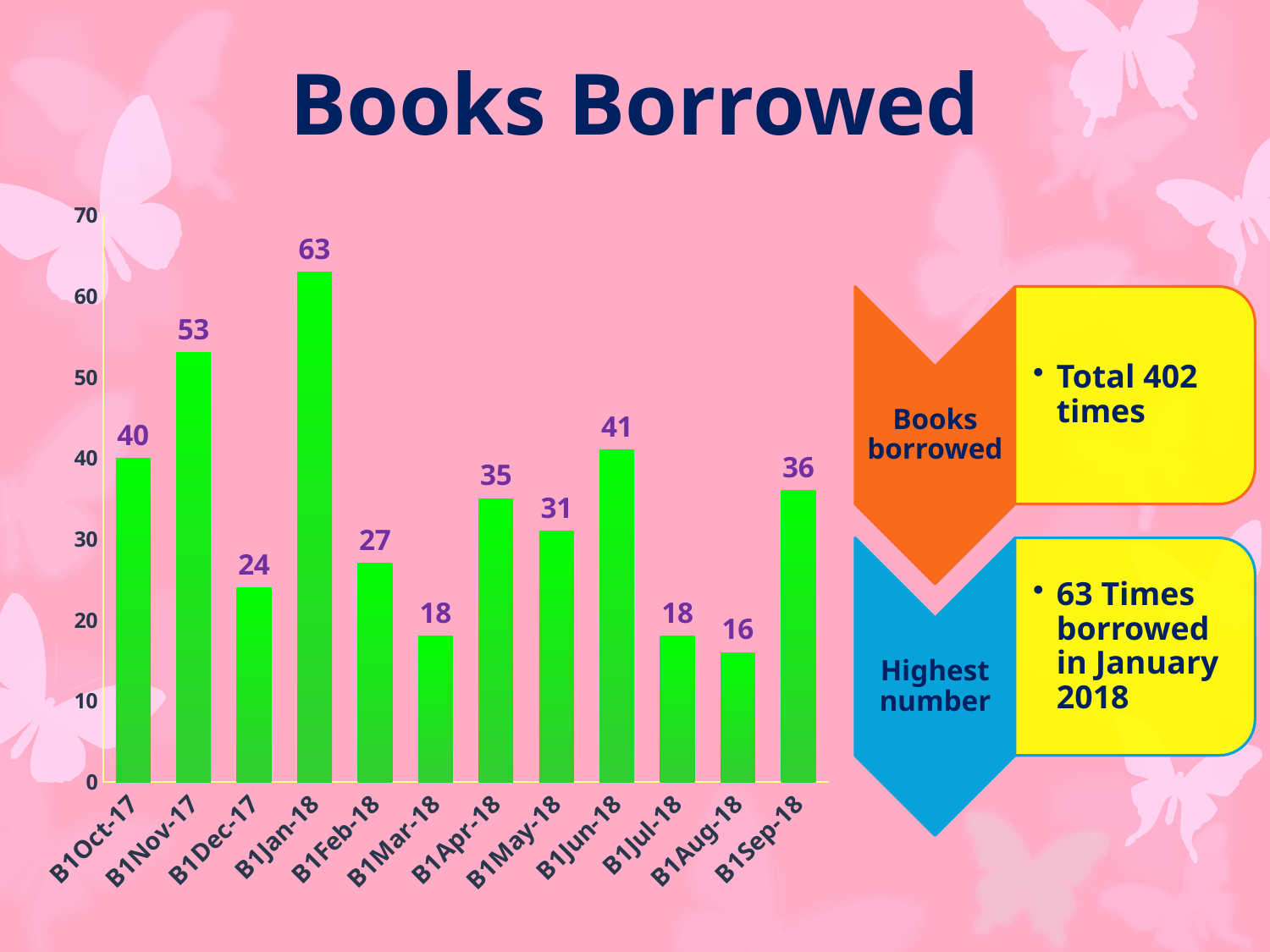
What is the value for B1Jan-18? 63 Is the value for B1Jun-18 greater or less than 40? greater What is the title of the slide containing the chart? Books Borrowed What is the value for B1Dec-17? 24 Which category has the highest value? B1Jan-18 Do the values rise or fall from B1Jun-18 to B1Aug-18? fall Which is larger, the value for B1Apr-18 or the value for B1May-18? B1Apr-18 What is the difference between the values for B1Nov-17 and B1Oct-17? 13 Which category has the lowest value? B1Aug-18 What kind of chart is shown on the slide? bar chart What is the value for B1Sep-18? 36 How many categories are shown on the x axis? 12